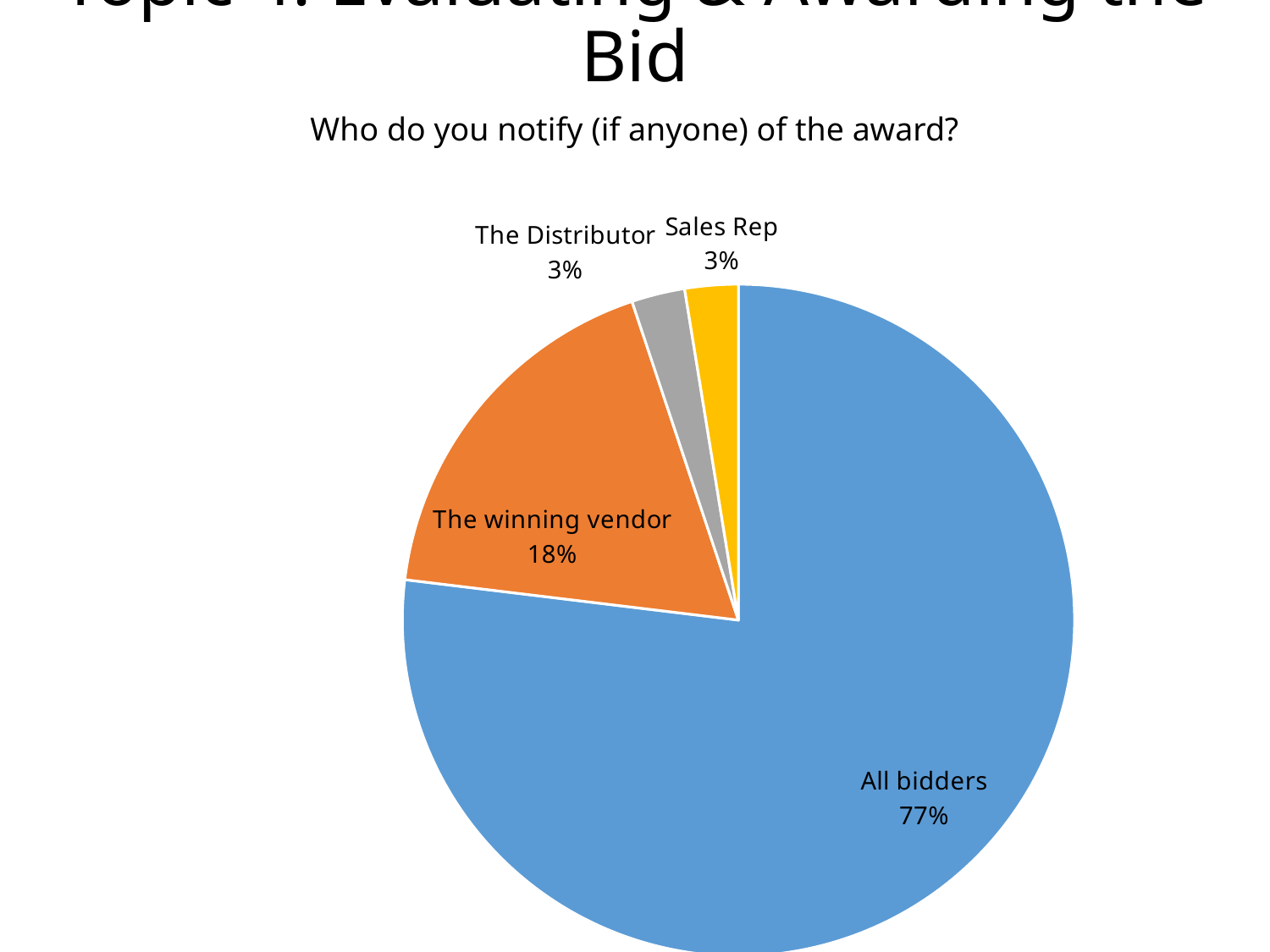
How many slices does the pie chart have? 4 What share of the pie is 'The Distributor'? 3% What colour is the 'All bidders' slice? blue Which category has the largest slice of the pie? All bidders What kind of chart is shown on the slide? pie chart What share of the pie is 'The winning vendor'? 18% What is the combined share of 'The Distributor' and 'Sales Rep'? 6% What is the difference between the shares for 'All bidders' and 'The winning vendor'? 59% Which is larger, the share for 'The winning vendor' or the share for 'The Distributor'? The winning vendor What share of the pie is 'Sales Rep'? 3% What is the title of the chart? Who do you notify (if anyone) of the award?